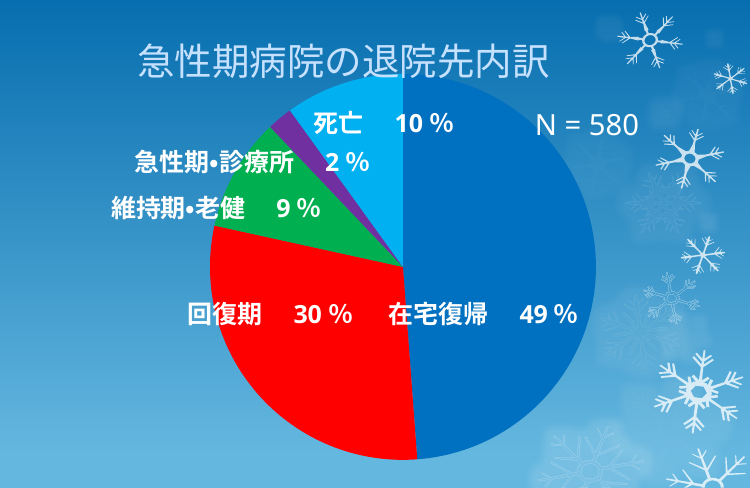
What is the value shown for 急性期・診療所? 2 % Which category has the smallest share of the pie? 急性期・診療所 What kind of chart is shown on the slide? pie chart How many categories are shown in the pie chart? 5 What is the value shown for 回復期? 30 % What is the title of the chart? 急性期病院の退院先内訳 What is the value shown for 死亡? 10 % What is the value shown for 在宅復帰? 49 % Which category has the largest share of the pie? 在宅復帰 What is the value shown for 維持期・老健? 9 % Which is larger, the share for 死亡 or the share for 維持期・老健? 死亡 What is the difference between the shares of 在宅復帰 and 回復期? 19 %